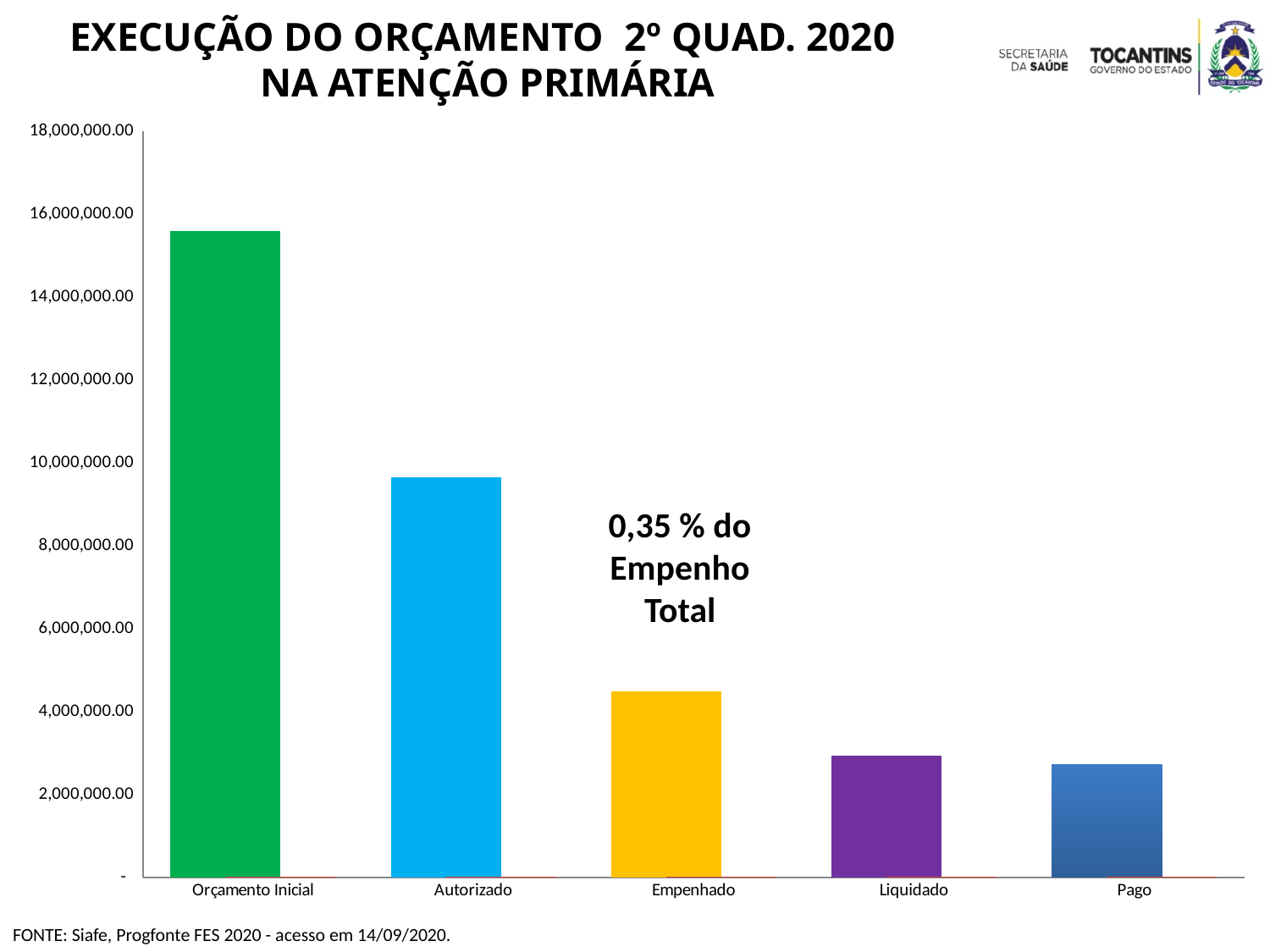
Which category has the highest value in the chart? Orçamento Inicial How many categories are shown on the x axis of the chart? 5 Is the value for Autorizado greater or less than 10,000,000.00? less Is the value for Liquidado greater or less than 4,000,000.00? less Is the value for Pago greater or less than 2,000,000.00? greater Do the values rise or fall from left to right along the x axis? fall What text annotation is printed above the Empenhado bar? 0,35 % do Empenho Total Which is larger, the value for Autorizado or the value for Empenhado? Autorizado Which is larger, the value for Orçamento Inicial or the value for Autorizado? Orçamento Inicial What kind of chart is shown on the slide? bar chart